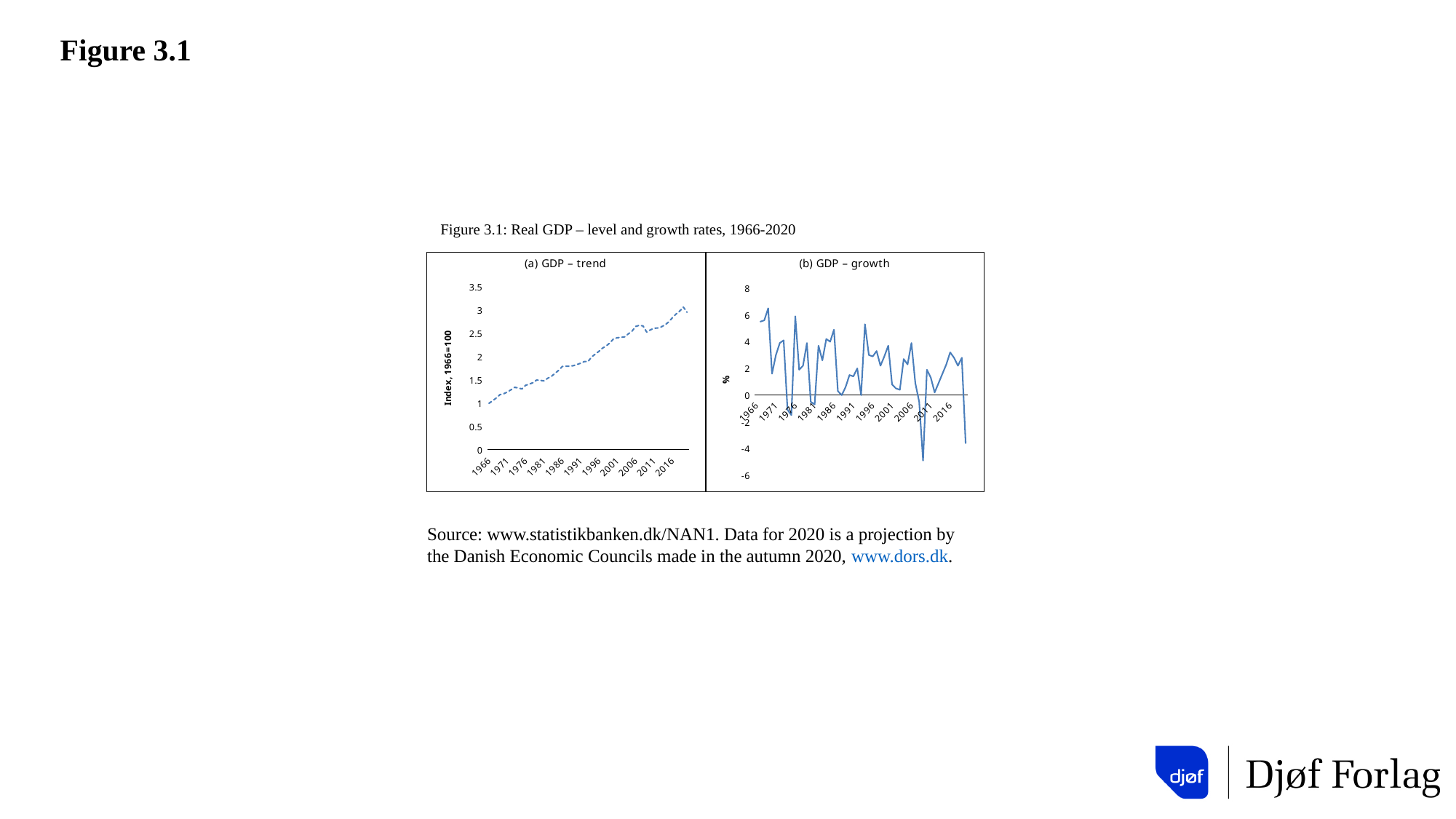
In the right chart '(b) GDP – growth', is the lowest value on the line greater or less than -4? less In the left chart '(a) GDP – trend', is the value for 1966 greater or less than 1.5? less What is the y-axis label of the right chart '(b) GDP – growth'? % In the left chart '(a) GDP – trend', is the value for 2001 greater or less than 2? greater What is the y-axis label of the left chart '(a) GDP – trend'? Index, 1966=100 What kind of chart is the right chart, '(b) GDP – growth'? line chart In the left chart '(a) GDP – trend', do the values generally rise or fall from 1966 to 2020? rise What kind of chart is the left chart, '(a) GDP – trend'? line chart In the left chart '(a) GDP – trend', which year has the lowest value? 1966